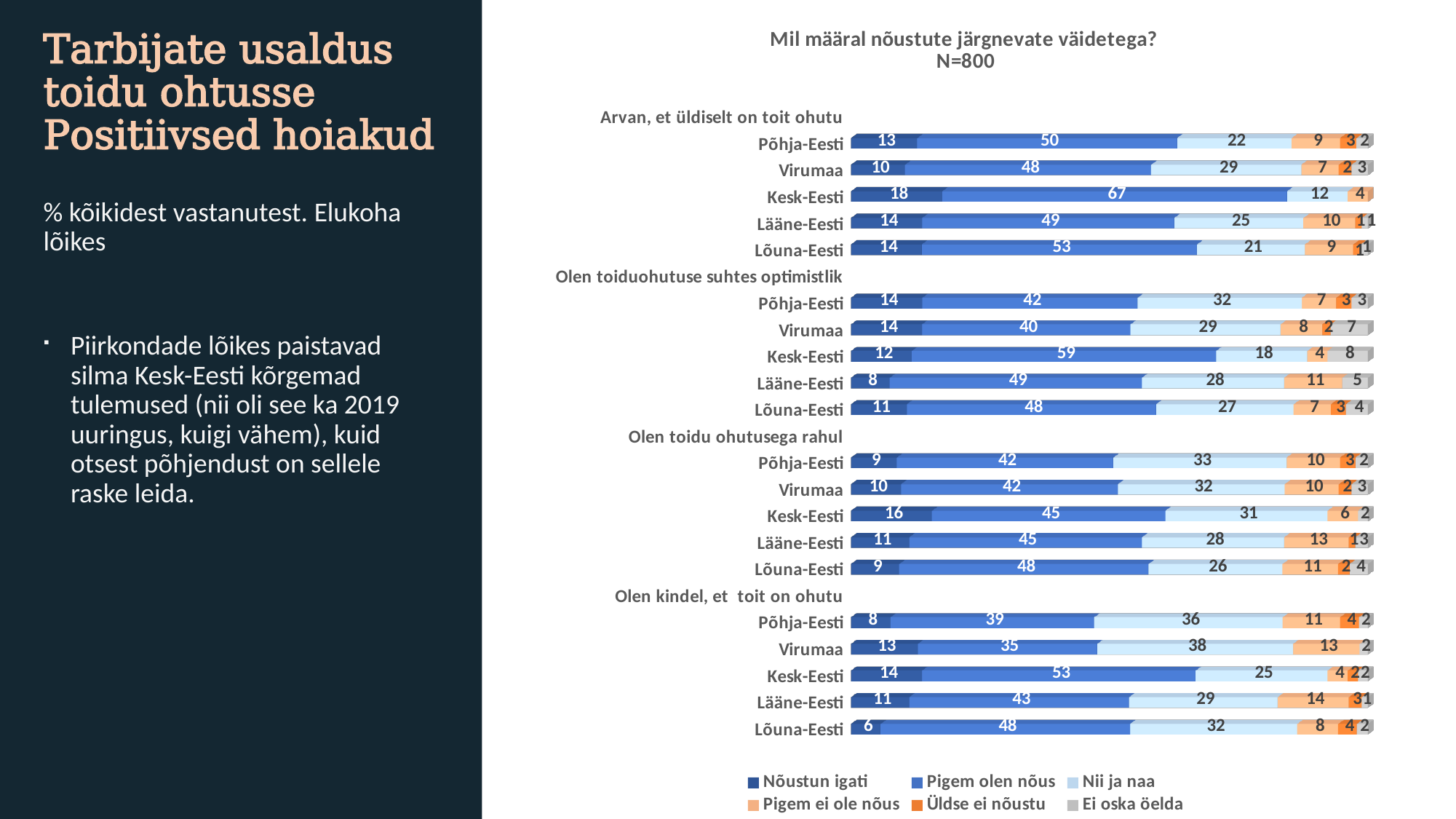
For the statement 'Olen toidu ohutusega rahul', what is the 'Nõustun igati' value for Kesk-Eesti? 16 How many series does the legend list? 6 What is the sample size (N) stated in the chart title? N=800 For the statement 'Arvan, et üldiselt on toit ohutu', what is the difference between the 'Pigem olen nõus' values of Kesk-Eesti and Põhja-Eesti? 17 For the statement 'Olen toiduohutuse suhtes optimistlik', which is larger: the 'Nii ja naa' value for Põhja-Eesti or for Kesk-Eesti? Põhja-Eesti For the statement 'Olen kindel, et toit on ohutu', which region has the lowest 'Nõustun igati' value? Lõuna-Eesti For the statement 'Olen kindel, et toit on ohutu', what is the 'Pigem ei ole nõus' value for Lääne-Eesti? 14 For the statement 'Arvan, et üldiselt on toit ohutu', what is the 'Pigem olen nõus' value for Kesk-Eesti? 67 For the statement 'Olen toiduohutuse suhtes optimistlik', which region has the highest 'Pigem olen nõus' value? Kesk-Eesti How many regions are shown under each statement in the chart? 5 What kind of chart is shown on the slide? Stacked bar chart For the statement 'Olen kindel, et toit on ohutu', what is the 'Nii ja naa' value for Virumaa? 38